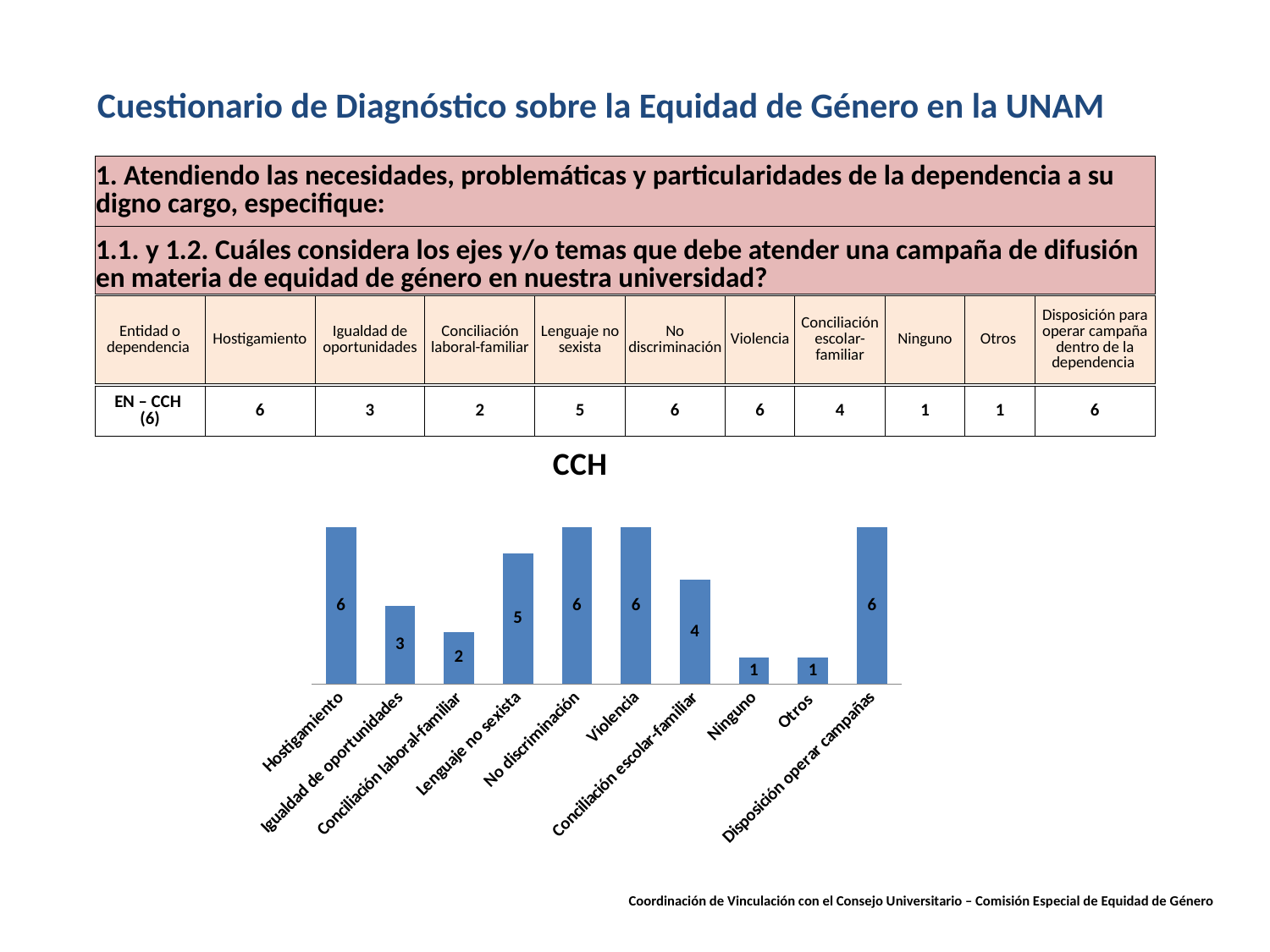
What is the difference between the values for Lenguaje no sexista and Igualdad de oportunidades in the CCH chart? 2 What is the value for Lenguaje no sexista in the CCH chart? 5 What is the value for Conciliación escolar-familiar in the CCH chart? 4 What is the difference between the values for Violencia and Conciliación escolar-familiar in the CCH chart? 2 What kind of chart is the CCH chart? Bar chart Which has a larger value in the CCH chart, Lenguaje no sexista or Conciliación laboral-familiar? Lenguaje no sexista What is the value for Hostigamiento in the CCH chart? 6 What is the value for Conciliación laboral-familiar in the CCH chart? 2 How many categories are shown in the CCH chart? 10 What is the value for Igualdad de oportunidades in the CCH chart? 3 What is the title of the chart on the slide? CCH What is the value for Ninguno in the CCH chart? 1